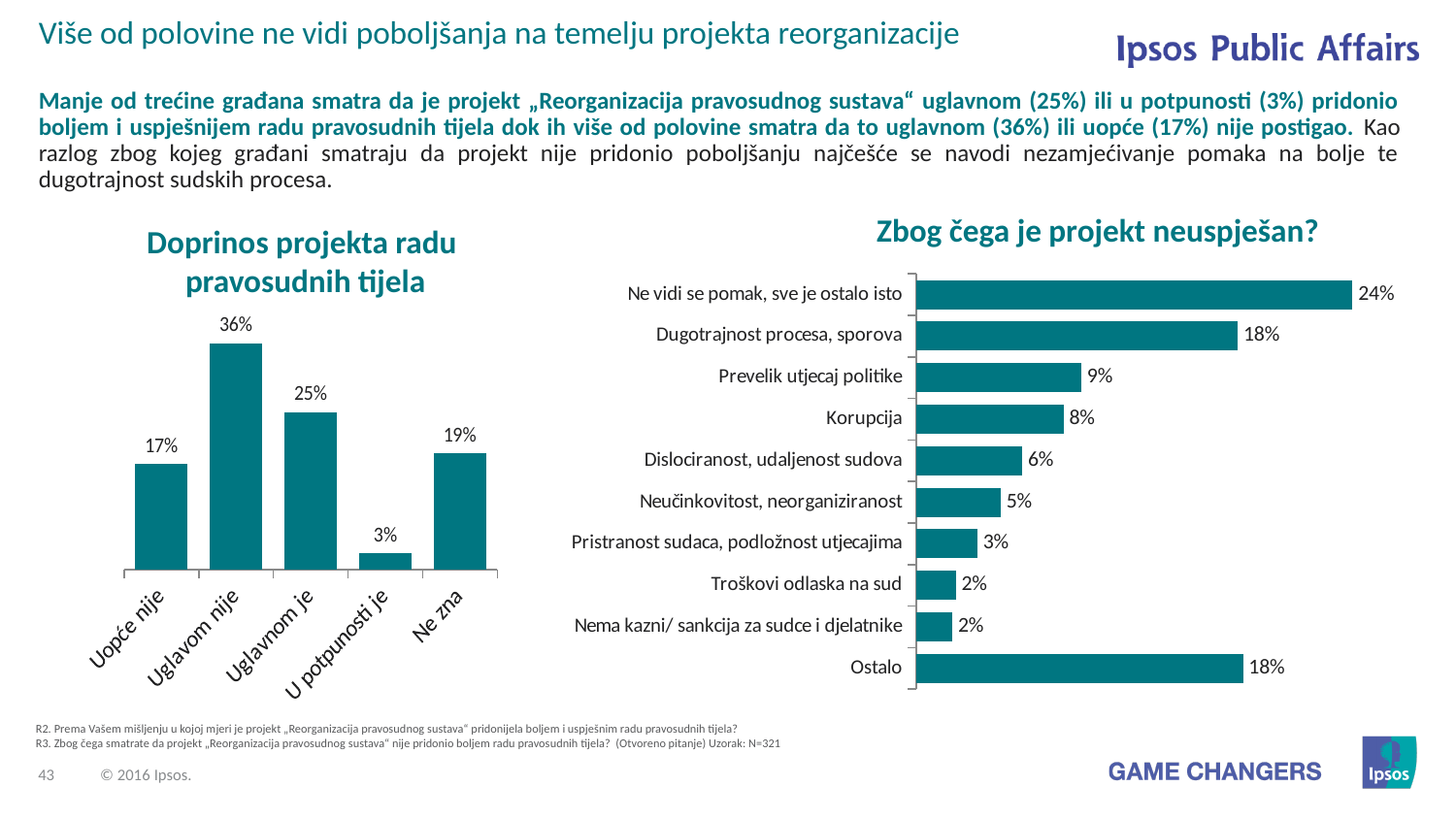
In the chart 'Zbog čega je projekt neuspješan?', how many categories are shown? 10 In the chart 'Doprinos projekta radu pravosudnih tijela', which is larger: 'Uopće nije' or 'Ne zna'? Ne zna What kind of chart is 'Zbog čega je projekt neuspješan?'? Bar chart In the chart 'Zbog čega je projekt neuspješan?', what is the difference between 'Dugotrajnost procesa, sporova' and 'Korupcija'? 10% In the chart 'Doprinos projekta radu pravosudnih tijela', what is the value for 'Uglavnom nije'? 36% In the chart 'Zbog čega je projekt neuspješan?', what is the value for 'Prevelik utjecaj politike'? 9% In the chart 'Zbog čega je projekt neuspješan?', what is the value for 'Dislociranost, udaljenost sudova'? 6% In the chart 'Doprinos projekta radu pravosudnih tijela', what is the difference between 'Uglavnom nije' and 'Uglavnom je'? 11% In the chart 'Doprinos projekta radu pravosudnih tijela', which category has the lowest value? U potpunosti je In the chart 'Zbog čega je projekt neuspješan?', which is larger: 'Neučinkovitost, neorganiziranost' or 'Pristranost sudaca, podložnost utjecajima'? Neučinkovitost, neorganiziranost In the chart 'Zbog čega je projekt neuspješan?', which category has the highest value? Ne vidi se pomak, sve je ostalo isto In the chart 'Doprinos projekta radu pravosudnih tijela', how many categories are shown? 5